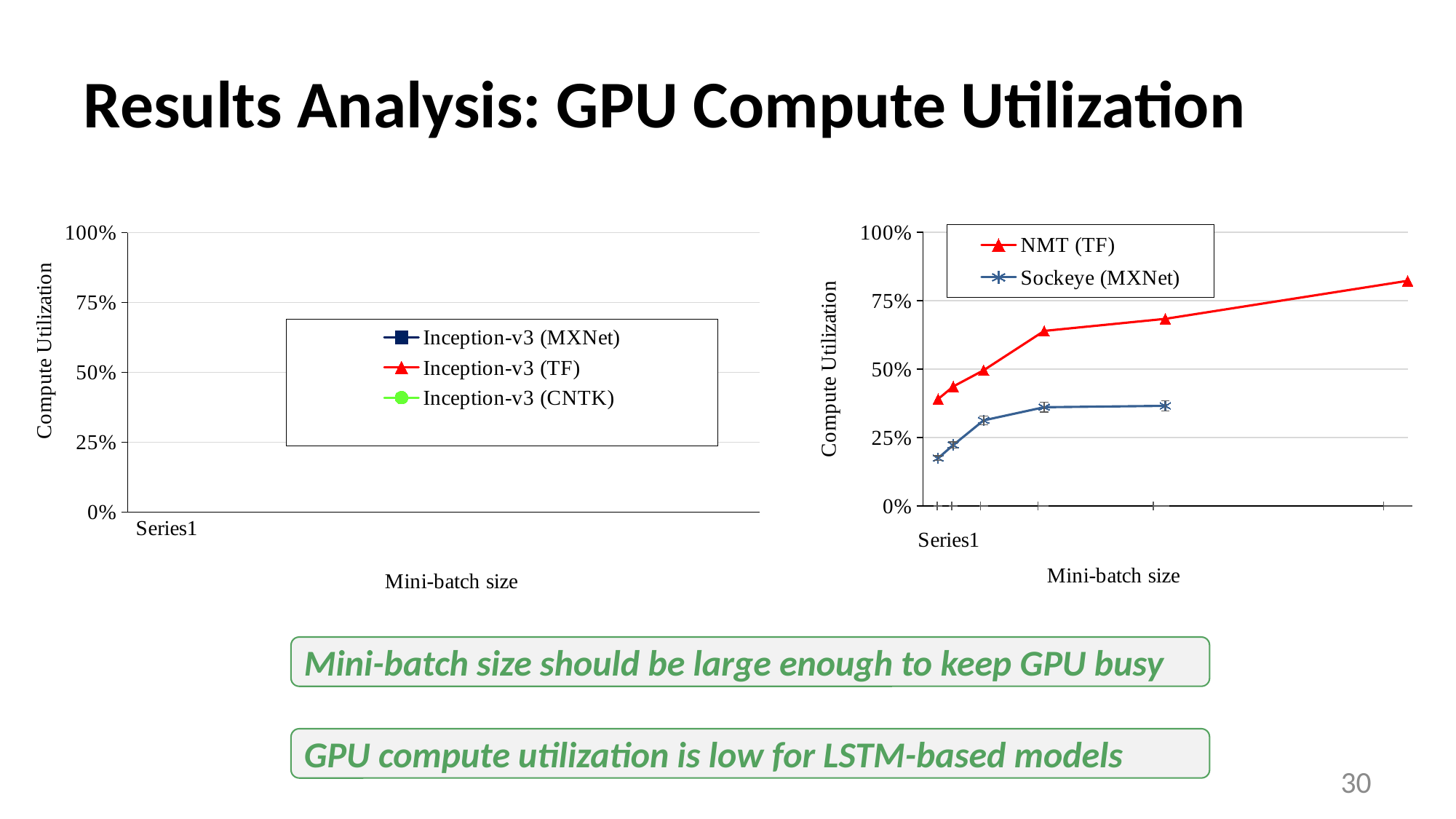
In the right chart, does the NMT (TF) series rise or fall as mini-batch size increases along the x axis? rise In the right chart, how many data points are plotted for Sockeye (MXNet)? 5 In the right chart, which series has the higher compute utilization at its rightmost point, NMT (TF) or Sockeye (MXNet)? NMT (TF) In the right chart, is the highest Sockeye (MXNet) value greater or less than 50%? less In the right chart, is the leftmost Sockeye (MXNet) value greater or less than 25%? less What kind of chart is the right chart? line chart In the right chart, is the rightmost NMT (TF) value greater or less than 75%? greater What is the x-axis label of the left chart? Mini-batch size In the left chart, how many series does the legend list? 3 In the right chart, how many series does the legend list? 2 In the right chart, how many data points are plotted for NMT (TF)? 6 What is the y-axis label of the right chart? Compute Utilization